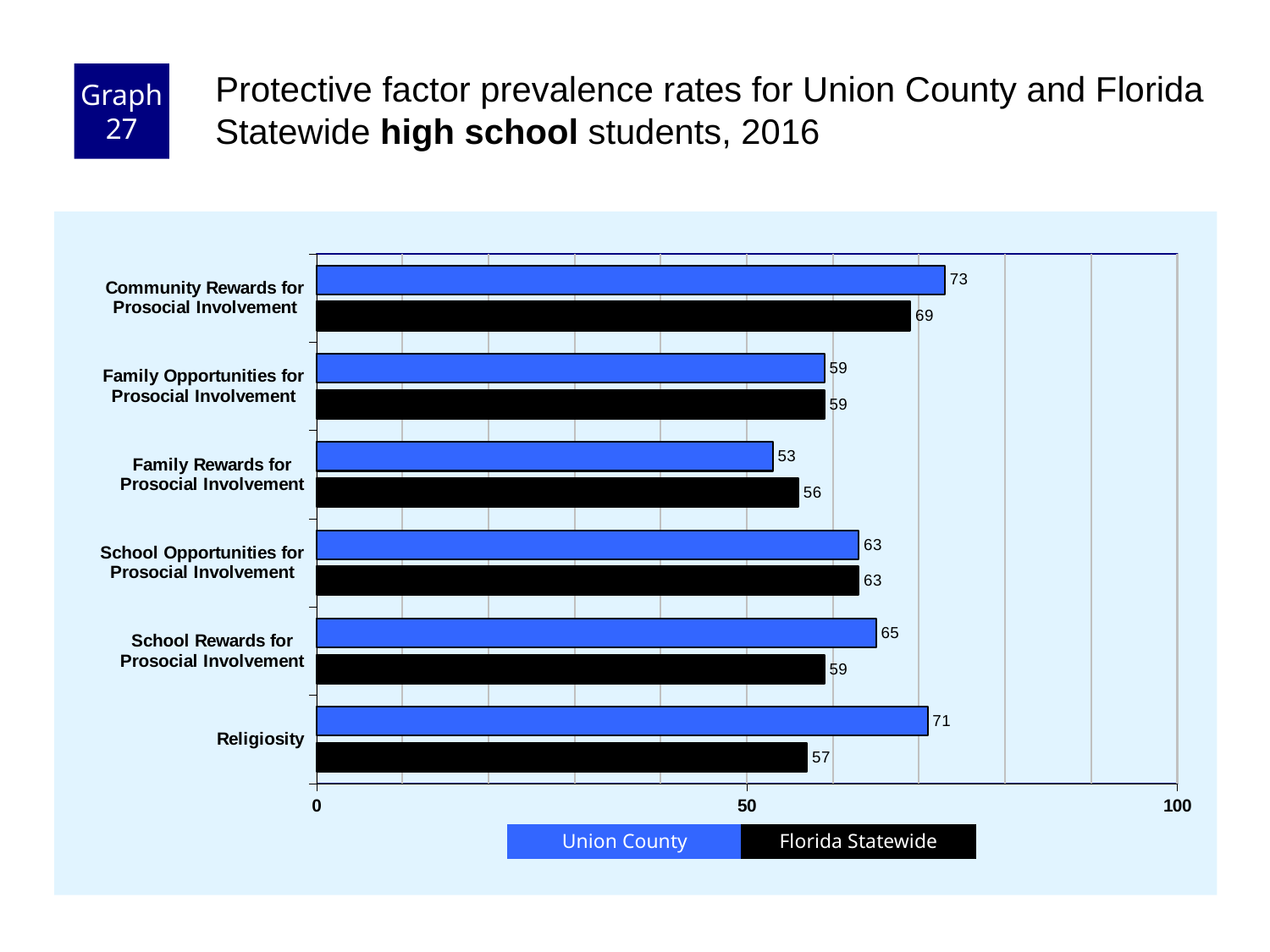
How many series does the legend list? 2 Which category has the lowest Union County value? Family Rewards for Prosocial Involvement What is the Union County value for Community Rewards for Prosocial Involvement? 73 What is the Florida Statewide value for Family Rewards for Prosocial Involvement? 56 Which colour represents Florida Statewide in the chart? black What kind of chart is shown on the slide? bar chart Is the Union County value for Religiosity greater or less than 50? greater How many categories are shown on the chart? 6 What is the Florida Statewide value for Religiosity? 57 Which category has the highest Union County value? Community Rewards for Prosocial Involvement What is the difference between the Union County and Florida Statewide values for Religiosity? 14 For School Rewards for Prosocial Involvement, which is larger: Union County or Florida Statewide? Union County